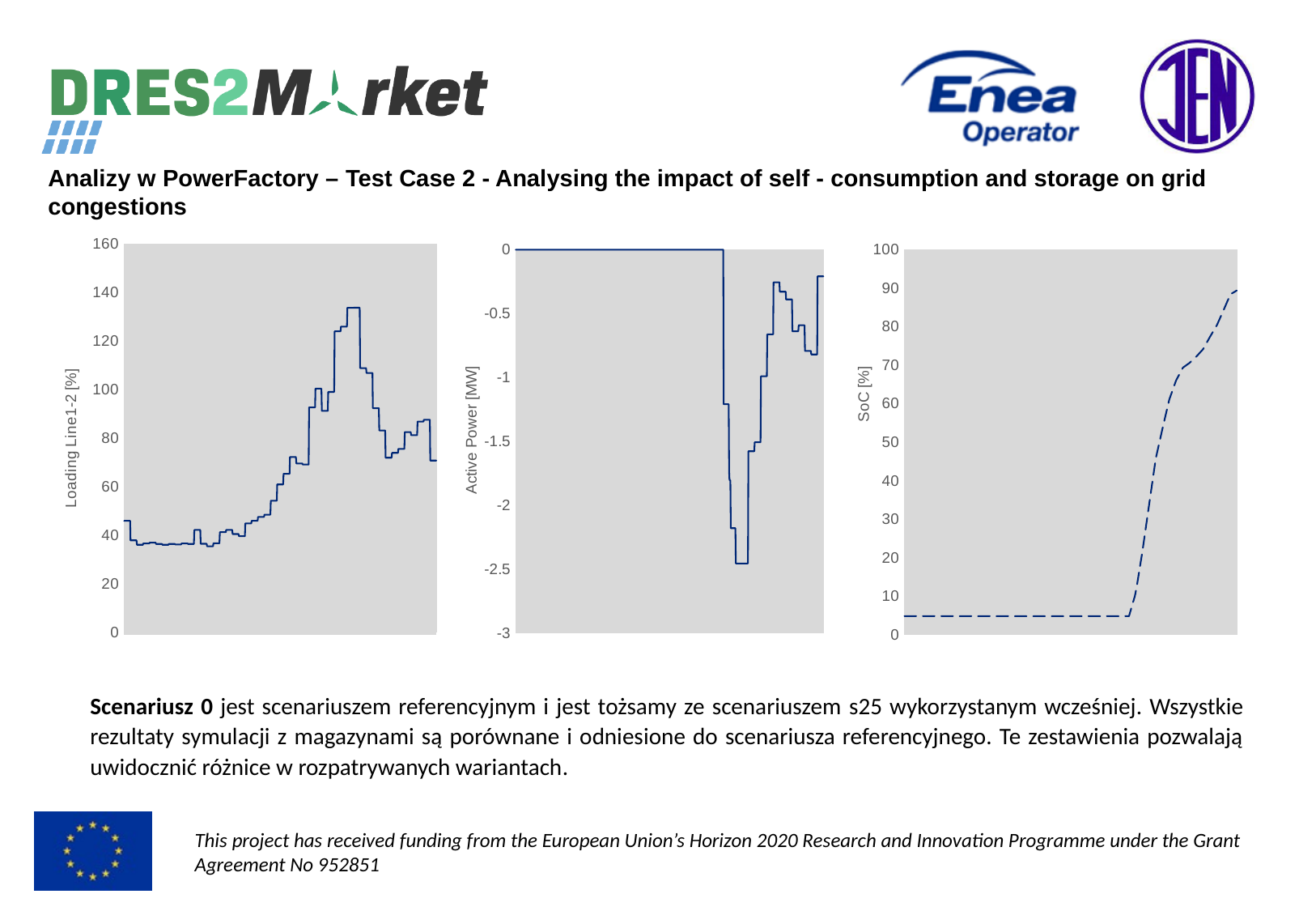
How many charts are shown on the slide? 3 What kind of chart is the right chart with the y-axis labelled 'SoC [%]'? line chart What is the y-axis label of the middle chart? Active Power [MW] In the right chart, is the SoC value at the end of the x axis greater or less than 80? greater What is the maximum value shown on the y axis of the left chart? 160 What kind of chart is the left chart with the y-axis labelled 'Loading Line1-2 [%]'? line chart In the right chart, does the SoC value rise or fall along the x axis? rise In the right chart, is the SoC value at the start of the x axis greater or less than 10? less In the middle chart, is the lowest value of Active Power greater or less than -2? less